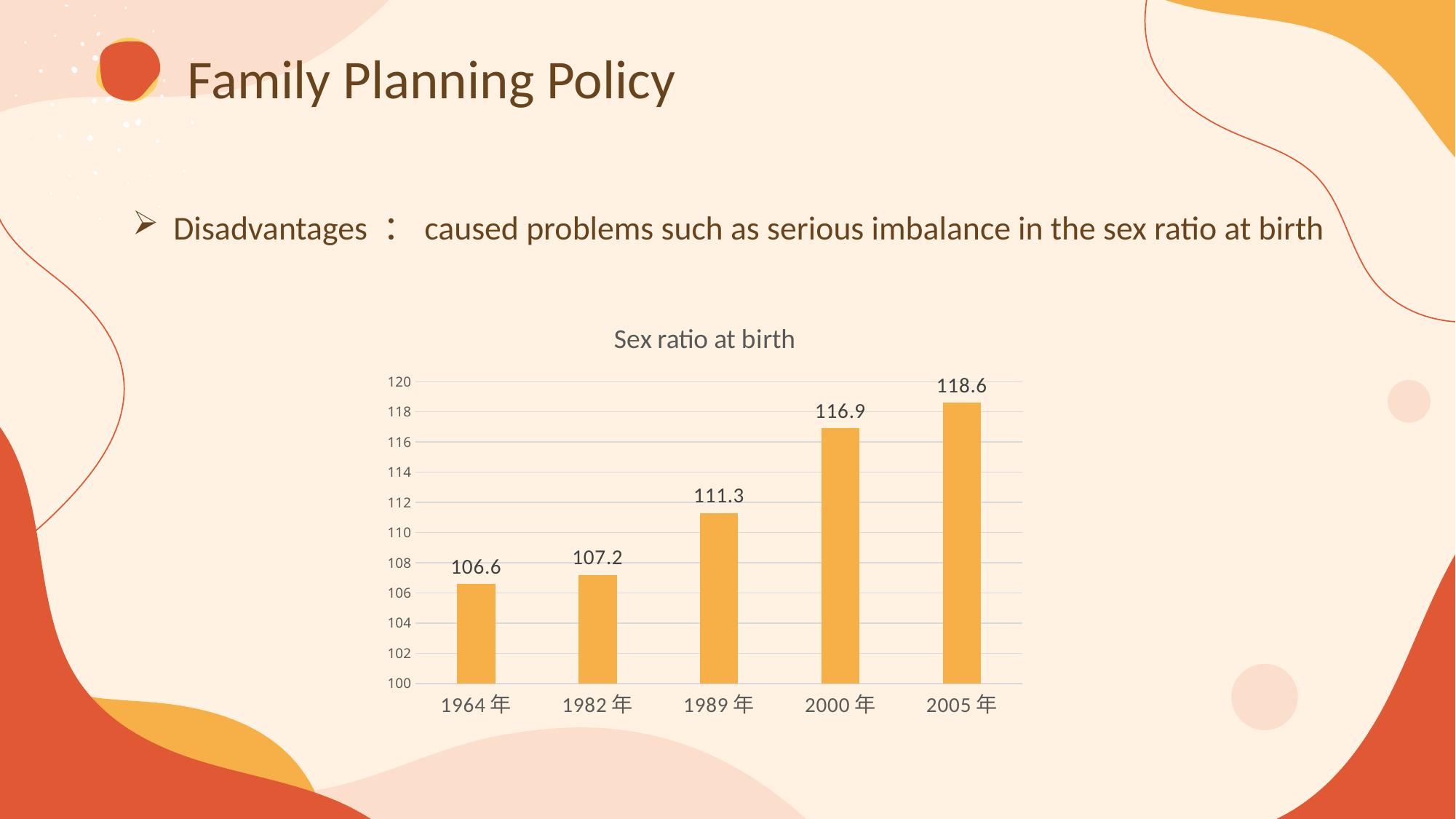
What is the difference between the sex ratio at birth in 2000 年 and in 1989 年? 5.6 Which is larger, the sex ratio at birth in 1982 年 or in 1989 年? 1989 年 Which year has the lowest sex ratio at birth? 1964 年 How many years are shown on the chart? 5 Is the value for 2005 年 greater or less than 118? greater What is the sex ratio at birth shown for 1989 年? 111.3 Do the values rise or fall from 1964 年 to 2005 年? Rise What is the sex ratio at birth shown for 1964 年? 106.6 What is the sex ratio at birth shown for 2000 年? 116.9 What kind of chart is shown on the slide? Bar chart What is the difference between the sex ratio at birth in 2005 年 and in 1964 年? 12 Which year has the highest sex ratio at birth? 2005 年